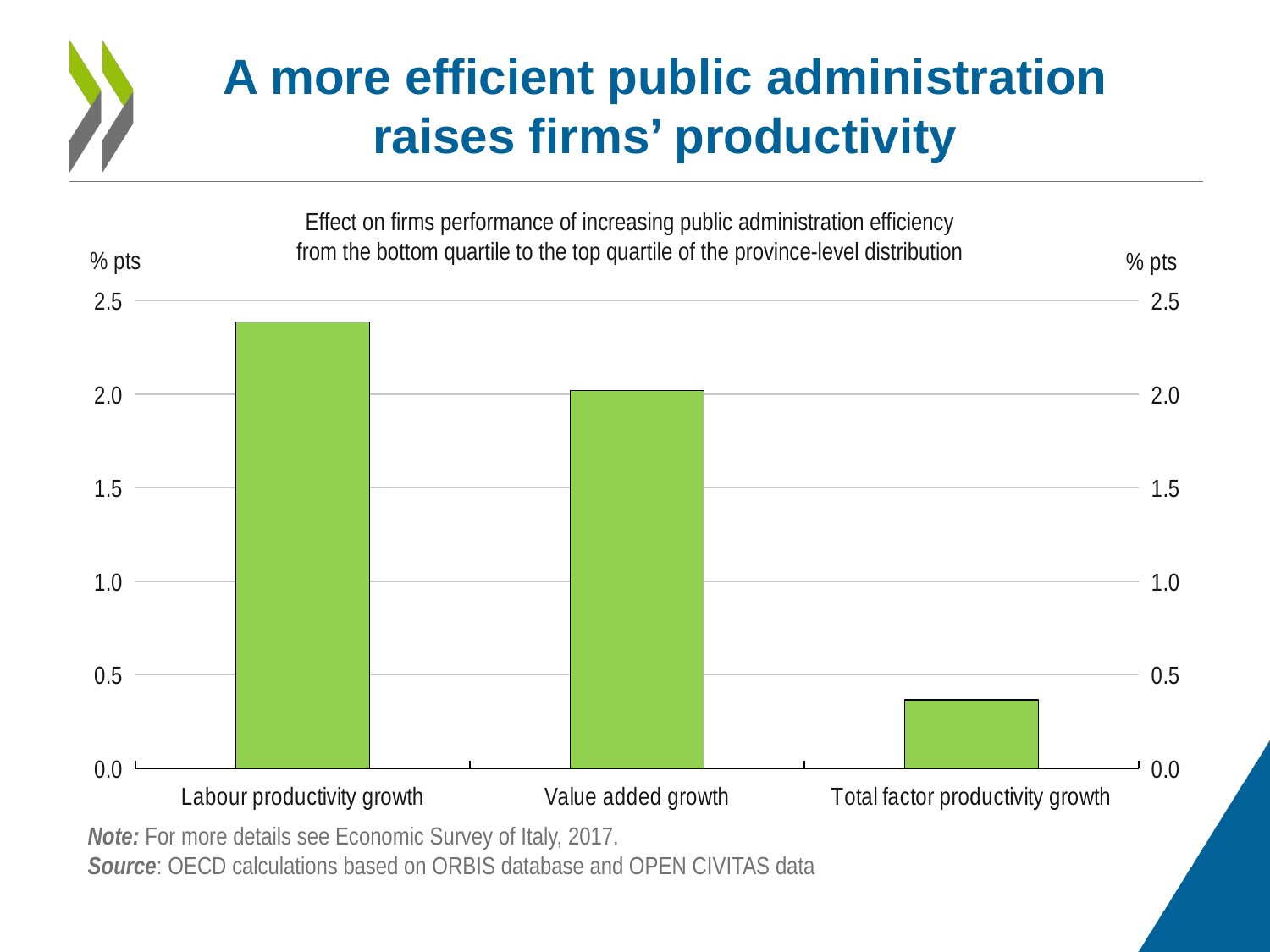
Is the value for Total factor productivity growth greater or less than 0.5? less How many categories are plotted in the chart? 3 What unit is shown on the vertical axis of the chart? % pts Is the value for Value added growth greater or less than 1.5? greater Which category has the lowest value in the chart? Total factor productivity growth Is the value for Labour productivity growth greater or less than 2.0? greater Which category has the highest value in the chart? Labour productivity growth Which is larger, the value for Value added growth or the value for Total factor productivity growth? Value added growth Which is larger, the value for Labour productivity growth or the value for Value added growth? Labour productivity growth What colour are the bars in the chart? Green Do the values rise or fall moving from left to right across the categories? Fall What kind of chart is shown on the slide? Bar chart